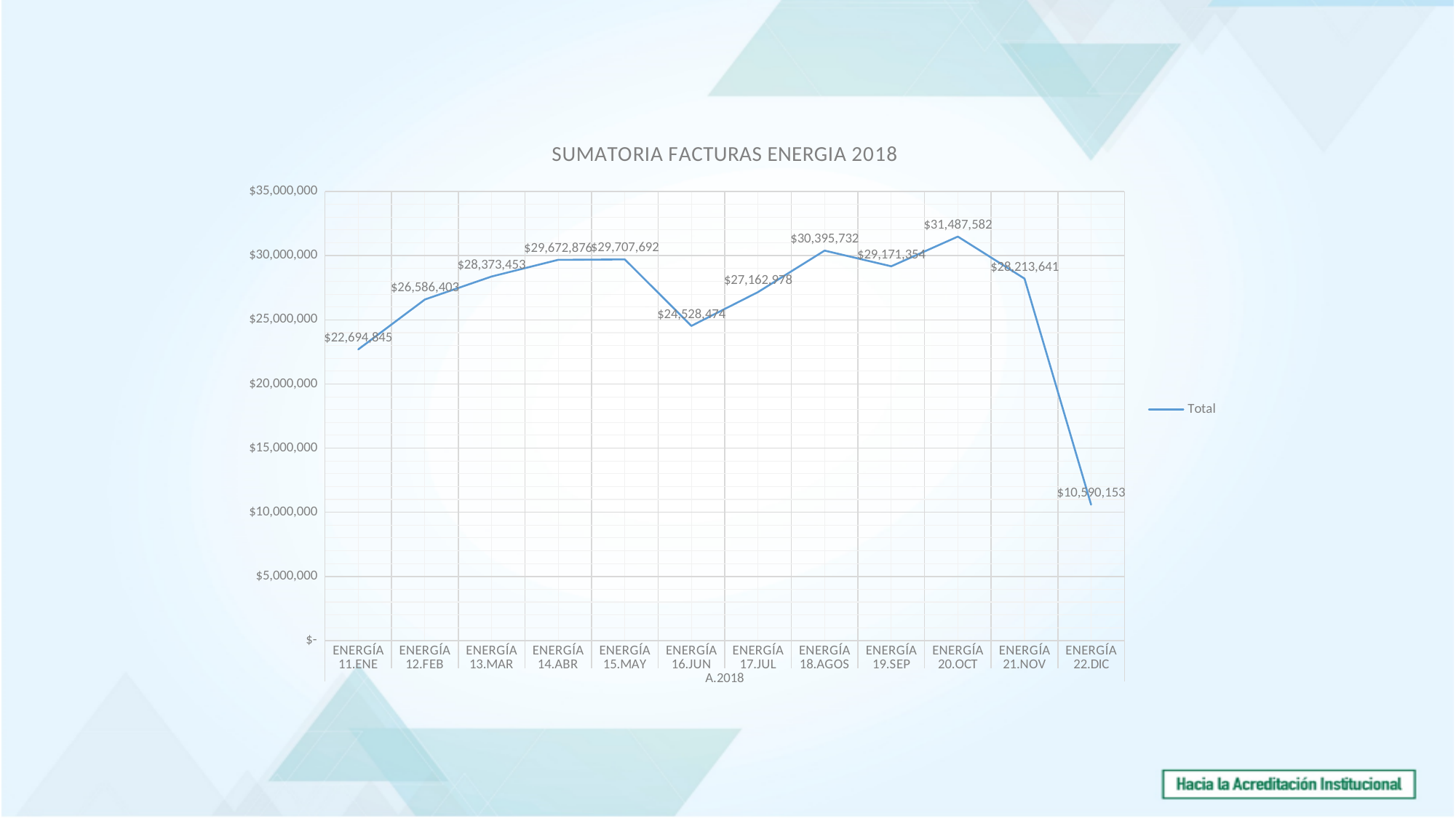
Is the value for ENERGÍA 16.JUN greater or less than $25,000,000? less Which category has the lowest value? ENERGÍA 22.DIC Which is larger, the value for ENERGÍA 18.AGOS or ENERGÍA 19.SEP? ENERGÍA 18.AGOS What type of chart is shown on the slide? Line chart What is the difference between the values for ENERGÍA 20.OCT and ENERGÍA 22.DIC? $20,897,429 Which category has the highest value? ENERGÍA 20.OCT Do the values rise or fall from ENERGÍA 20.OCT to ENERGÍA 22.DIC? fall How many series does the legend list? 1 What is the value for ENERGÍA 11.ENE? $22,694,845 How many data points are plotted on the line? 12 What is the value for ENERGÍA 18.AGOS? $30,395,732 What is the title of the chart? SUMATORIA FACTURAS ENERGIA 2018